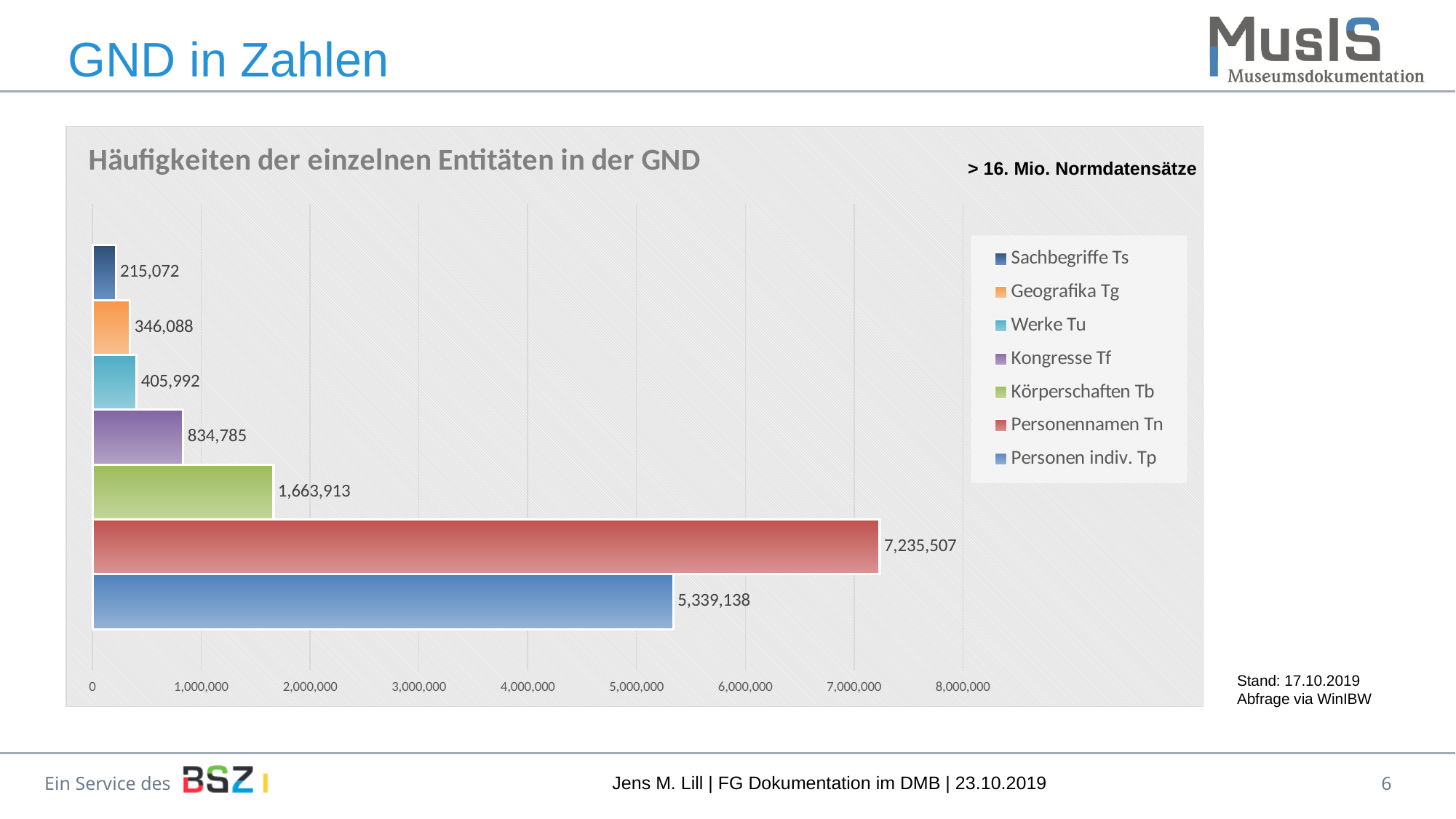
Which is larger, Kongresse Tf or Werke Tu? Kongresse Tf What is the value for Personen indiv. Tp? 5,339,138 Which entity type has the lowest value? Sachbegriffe Ts What is the value for Personennamen Tn? 7,235,507 How many series does the legend list? 7 What is the value for Körperschaften Tb? 1,663,913 What kind of chart is shown on the slide? bar chart What is the difference between Personennamen Tn and Personen indiv. Tp? 1,896,369 What is the value for Sachbegriffe Ts? 215,072 What is the title of the chart? Häufigkeiten der einzelnen Entitäten in der GND Is the value for Körperschaften Tb greater or less than 2,000,000? less Which entity type has the highest value? Personennamen Tn